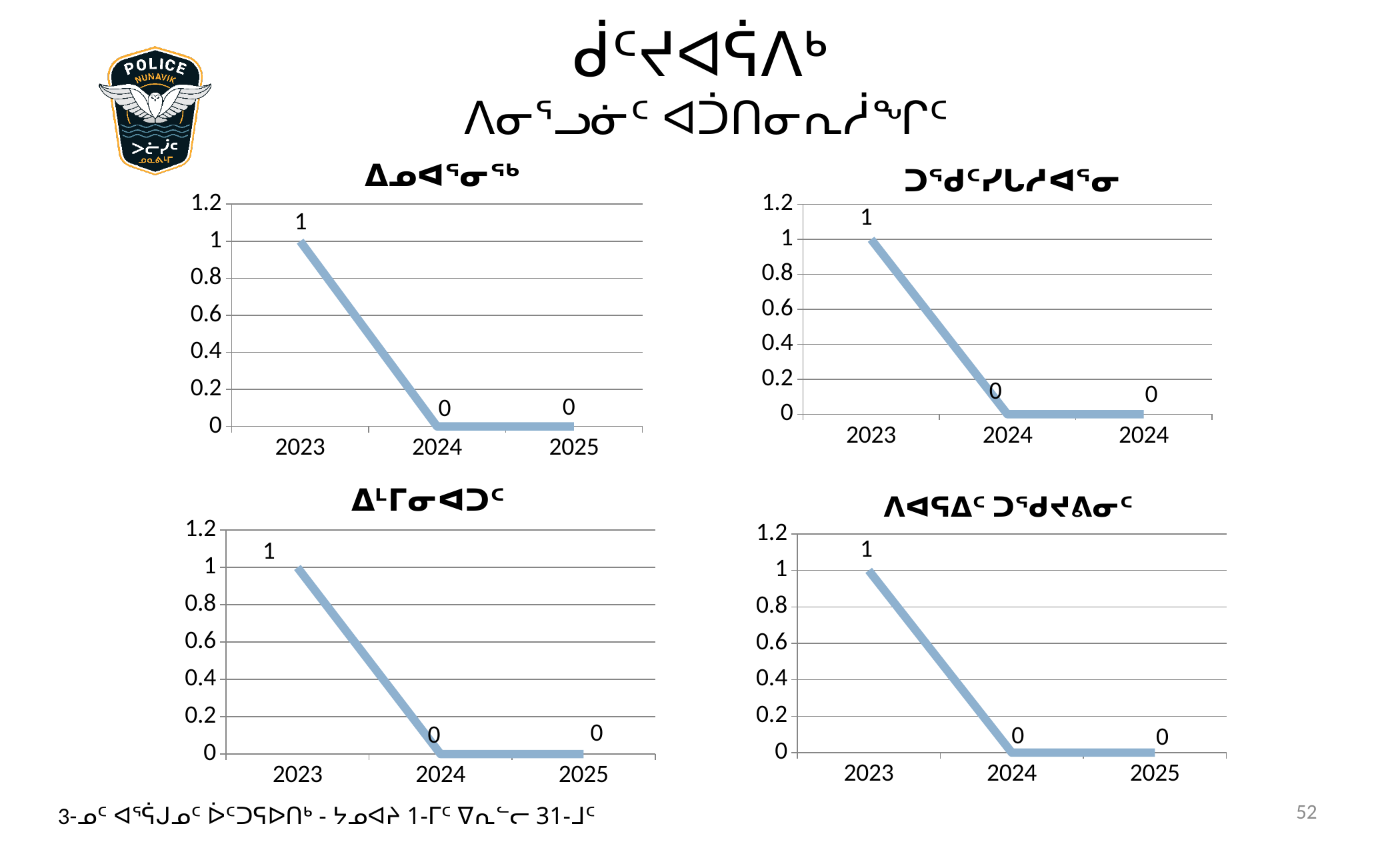
In the top-left chart, what is the difference between the values for 2023 and 2024? 1 In the top-left chart, what is the value for 2023? 1 In the bottom-right chart, what is the value for 2024? 0 What kind of chart is the top-right chart? Line chart In the top-right chart, what is the value for 2023? 1 In the bottom-left chart, how many data points are plotted? 3 In the top-left chart, which year has the highest value? 2023 In the top-right chart, what is the label of the last category on the x axis? 2024 How many charts are shown on the slide? 4 In the bottom-right chart, which is larger, the value for 2023 or the value for 2025? 2023 In the bottom-left chart, do the values rise or fall from 2023 to 2025? Fall In the top-left chart, what is the value for 2025? 0